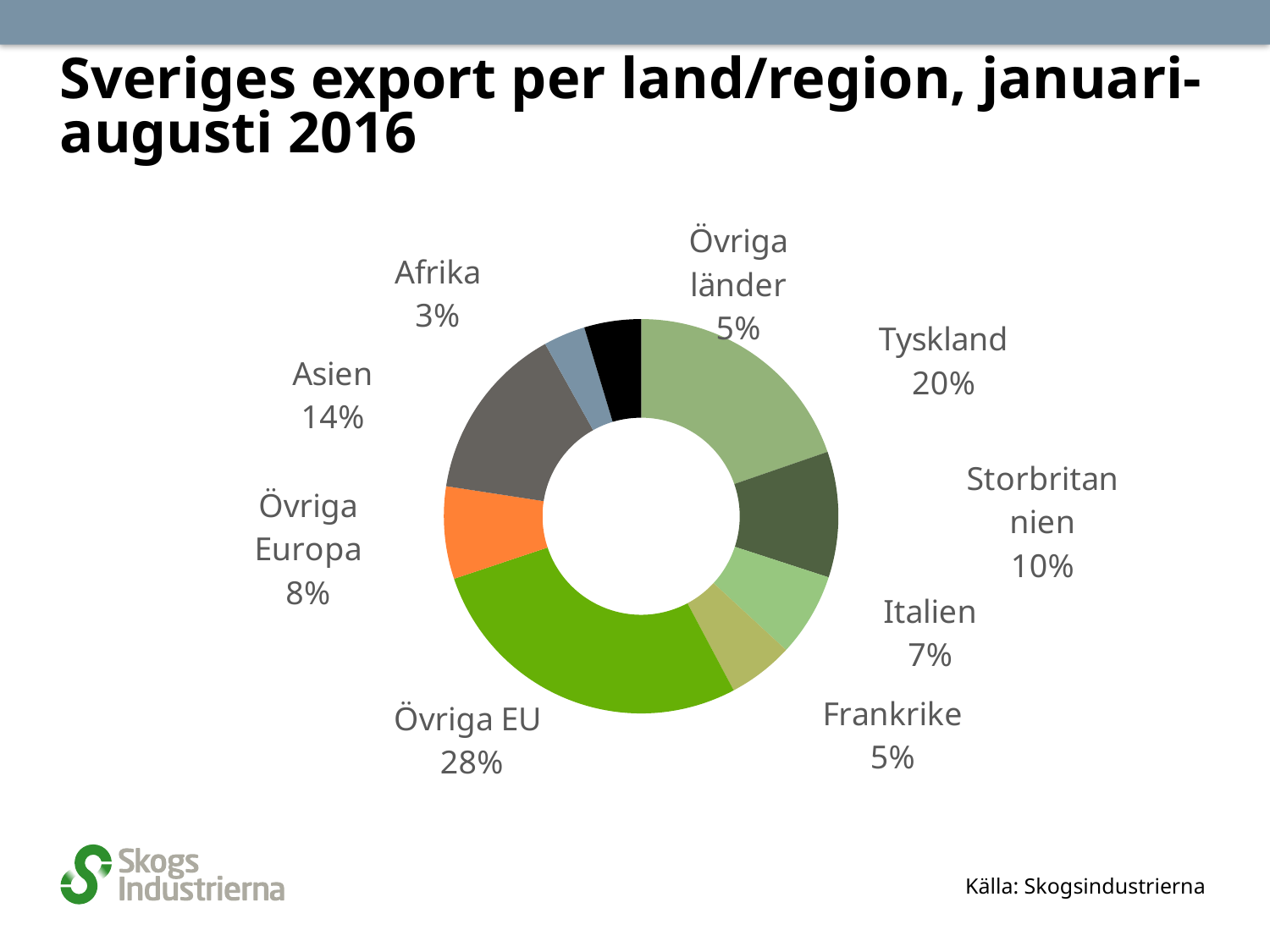
What is the source cited for the chart? Skogsindustrierna Which has a larger share of Sweden's export, Italien or Övriga Europa? Övriga Europa What share of Sweden's export goes to Övriga EU? 28% What share of Sweden's export goes to Tyskland? 20% How many countries or regions are shown in the chart? 9 What share of Sweden's export goes to Storbritannien? 10% Which country or region has the smallest share of Sweden's export? Afrika What is the combined share of Frankrike and Övriga länder? 10% What kind of chart is shown on the slide? Pie chart (doughnut) What share of Sweden's export goes to Asien? 14% What is the difference in percentage points between the shares for Övriga EU and Tyskland? 8 Which country or region has the largest share of Sweden's export? Övriga EU